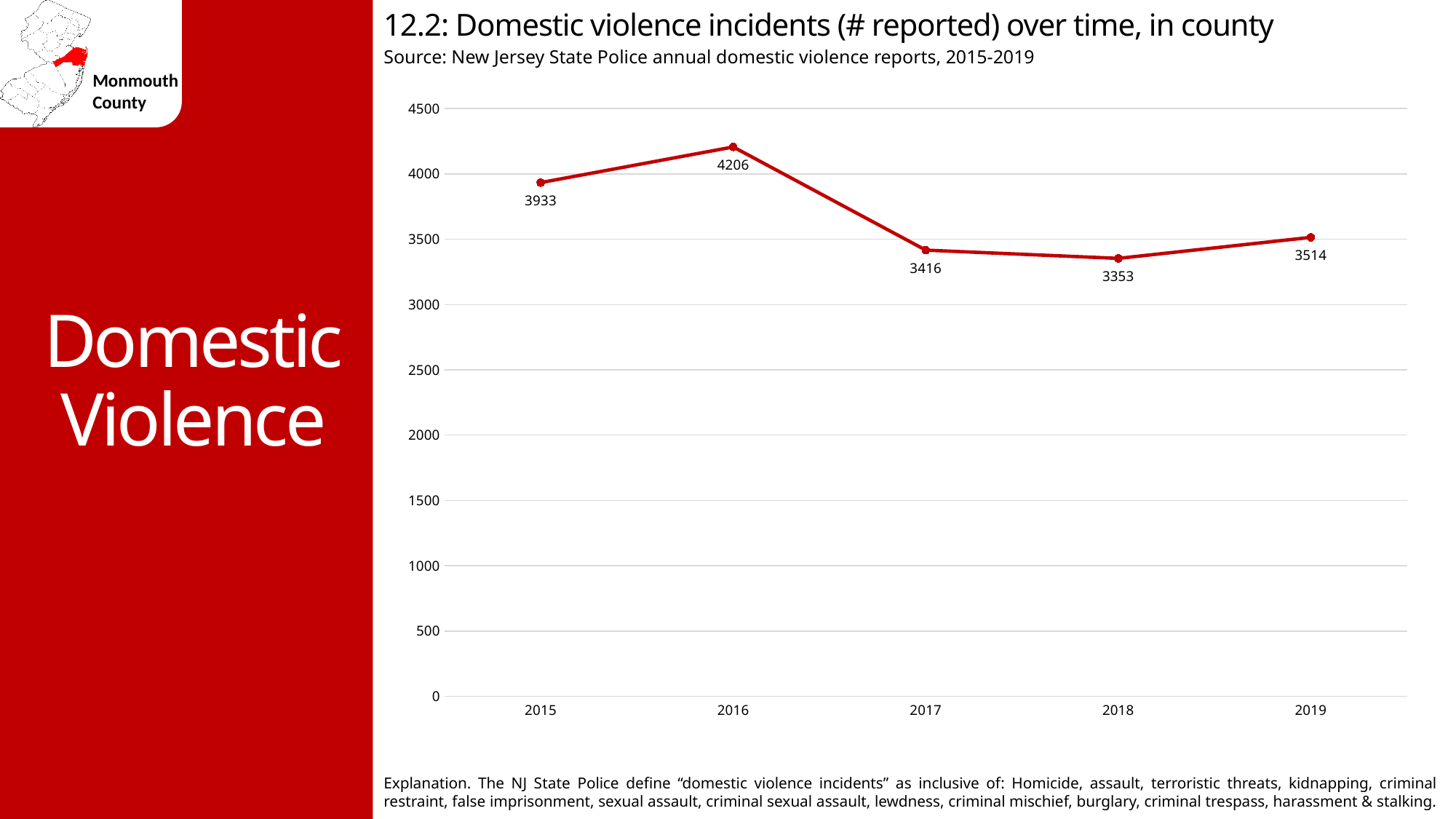
By how much did reported incidents increase from 2018 to 2019? 161 Which year has the lowest number of reported incidents? 2018 Did the number of reported incidents rise or fall from 2016 to 2017? fall How many incidents were reported in 2019? 3514 How many domestic violence incidents were reported in 2015? 3933 Which year had more reported incidents, 2015 or 2019? 2015 What is the difference between the 2016 and 2017 values? 790 What kind of chart is shown on the slide? line chart Which year has the highest number of reported domestic violence incidents? 2016 Is the value for 2016 greater or less than 4000? greater What is the value plotted for 2018? 3353 How many years are plotted on the chart? 5